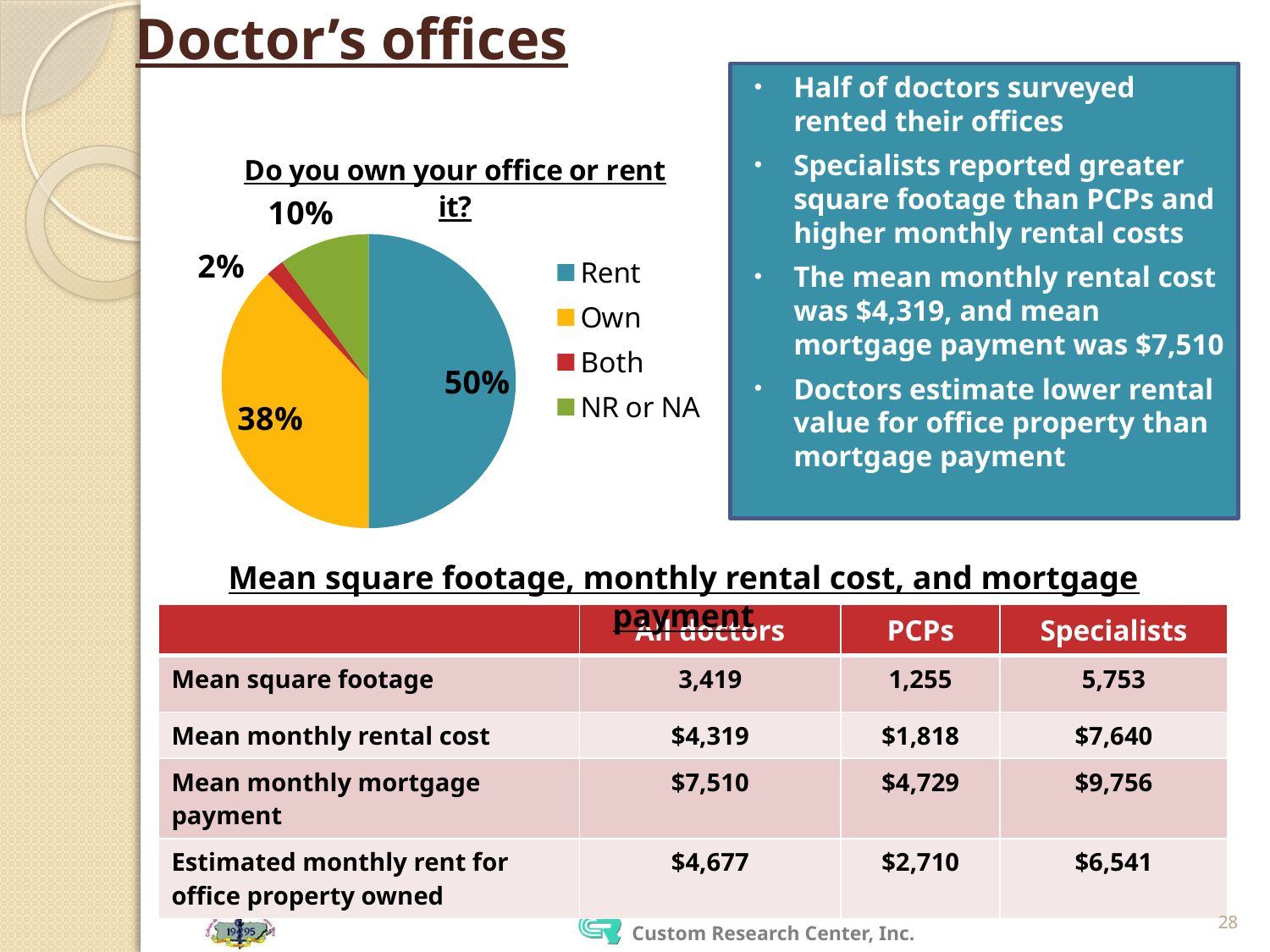
How many categories does the pie chart show? 4 What is the title of the pie chart? Do you own your office or rent it? What is the difference in percentage points between the Rent and Own slices? 12% What colour is the Rent slice in the pie chart? blue Which slice is larger, Own or NR or NA? Own What share of the pie chart is labelled "Both"? 2% What percentage of doctors rent their office according to the pie chart? 50% What kind of chart is shown on the slide? pie chart What share of the pie chart is labelled "NR or NA"? 10% Which category has the largest slice in the pie chart? Rent Which category has the smallest slice in the pie chart? Both What percentage of doctors own their office according to the pie chart? 38%